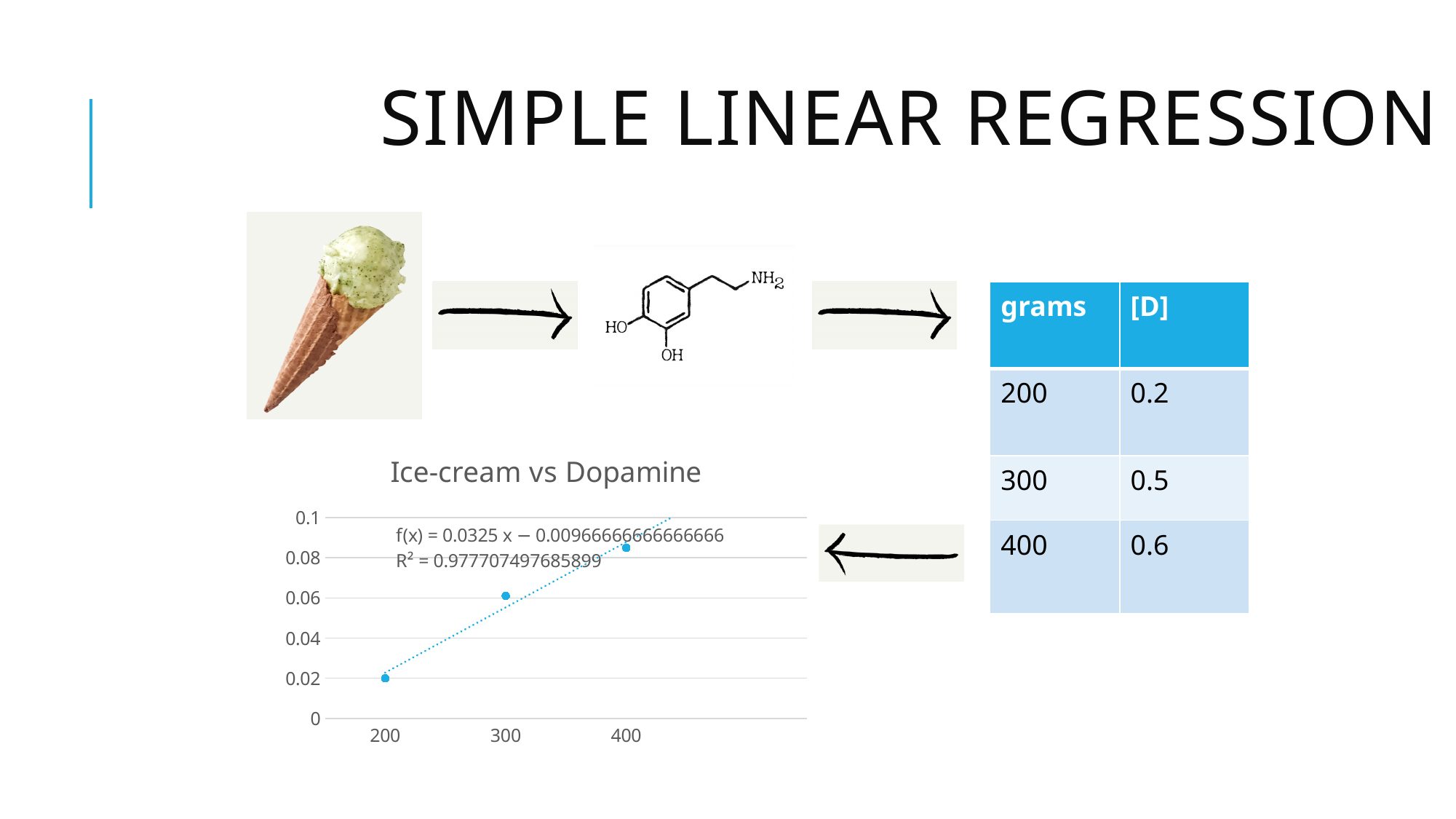
Is the plotted value at x = 300 greater or less than 0.04? greater Which has the larger plotted value, x = 300 or x = 200? 300 Is the plotted value at x = 400 greater or less than 0.1? less Which has the larger plotted value, x = 400 or x = 300? 400 Which x value has the highest plotted y value? 400 Which x value has the lowest plotted y value? 200 How many data points are plotted in the chart? 3 What type of chart is shown on the slide? Scatter chart What R² value is shown for the trendline on the chart? R² = 0.977707497685899 What is the title of the chart? Ice-cream vs Dopamine What is the plotted y value at x = 200? 0.02 Do the plotted values rise or fall as x increases from 200 to 400? Rise